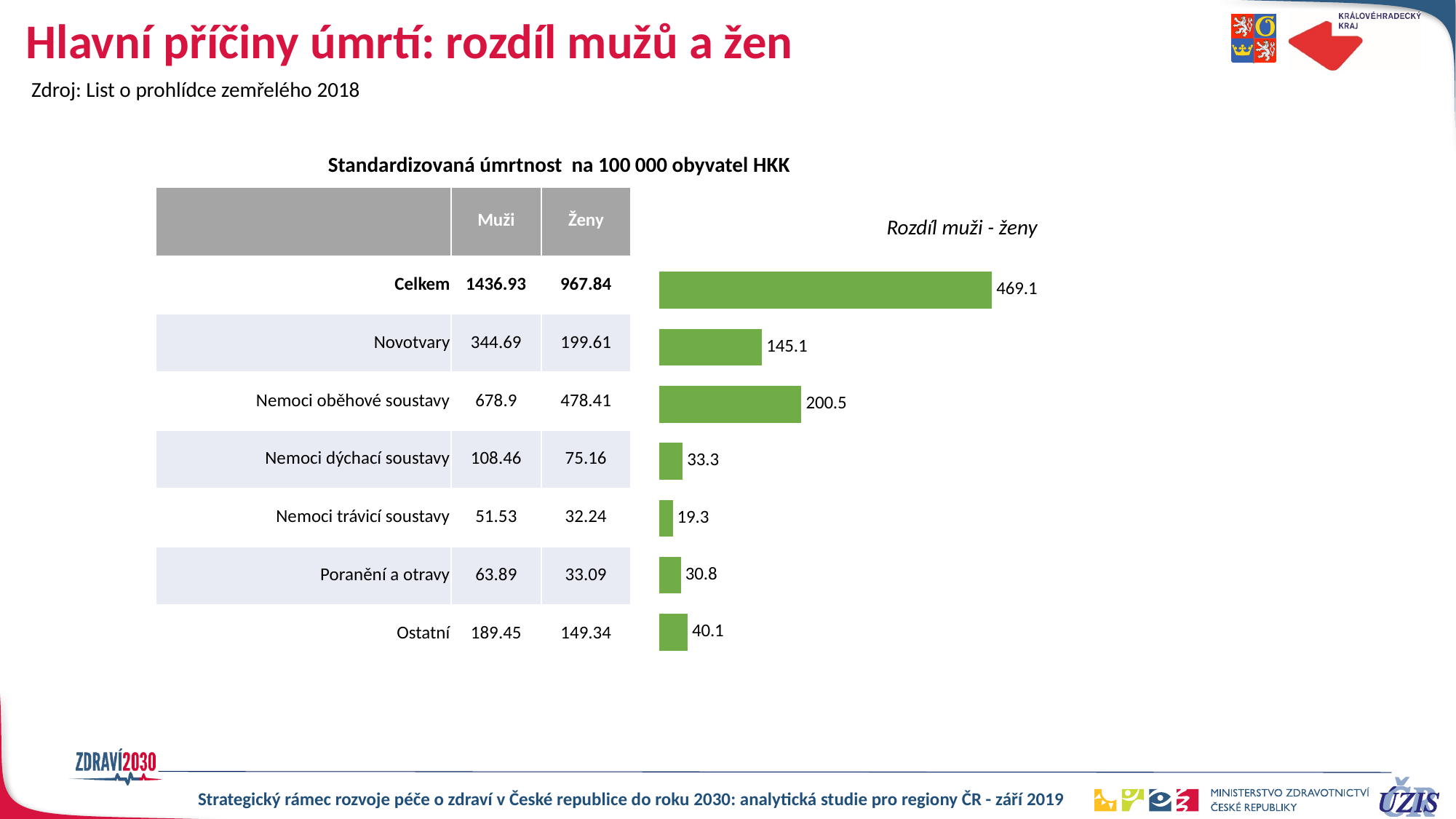
Which bar is larger: Ostatní or Nemoci dýchací soustavy? Ostatní What is the difference between the bar values for Nemoci oběhové soustavy and Novotvary? 55.4 Which category has the lowest bar in the chart? Nemoci trávicí soustavy What is the value of the bar for Nemoci trávicí soustavy? 19.3 What is the title of the chart on the slide? Rozdíl muži - ženy What is the value of the bar for Nemoci oběhové soustavy? 200.5 What colour are the bars in the chart? green How many bars does the chart show? 7 Which category has the highest bar in the chart? Celkem What is the value of the bar for Novotvary? 145.1 What is the value of the bar for Celkem? 469.1 What kind of chart is shown on the slide? bar chart